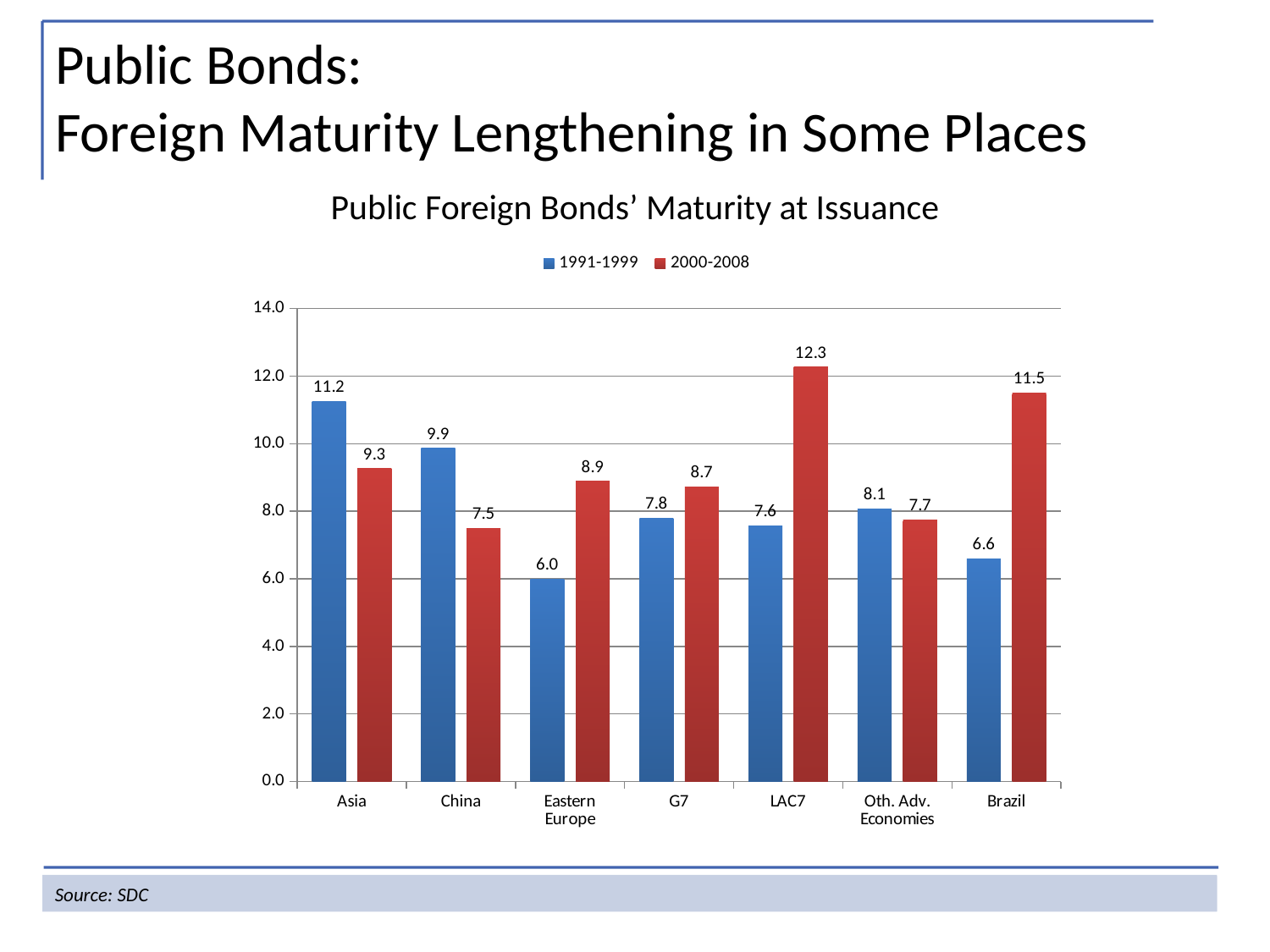
What kind of chart is shown? bar chart What is the 2000-2008 value for Brazil? 11.5 Which category has the highest 2000-2008 value? LAC7 Is the 1991-1999 value for Eastern Europe greater or less than 8.0? less What is the 2000-2008 value for LAC7? 12.3 Which is larger for China: the 1991-1999 value or the 2000-2008 value? 1991-1999 How many categories are shown on the x axis? 7 What is the difference between the 2000-2008 and 1991-1999 values for Brazil? 4.9 What is the title of the chart? Public Foreign Bonds' Maturity at Issuance Which category has the lowest 1991-1999 value? Eastern Europe What is the 1991-1999 value for Asia? 11.2 How many series does the legend list? 2